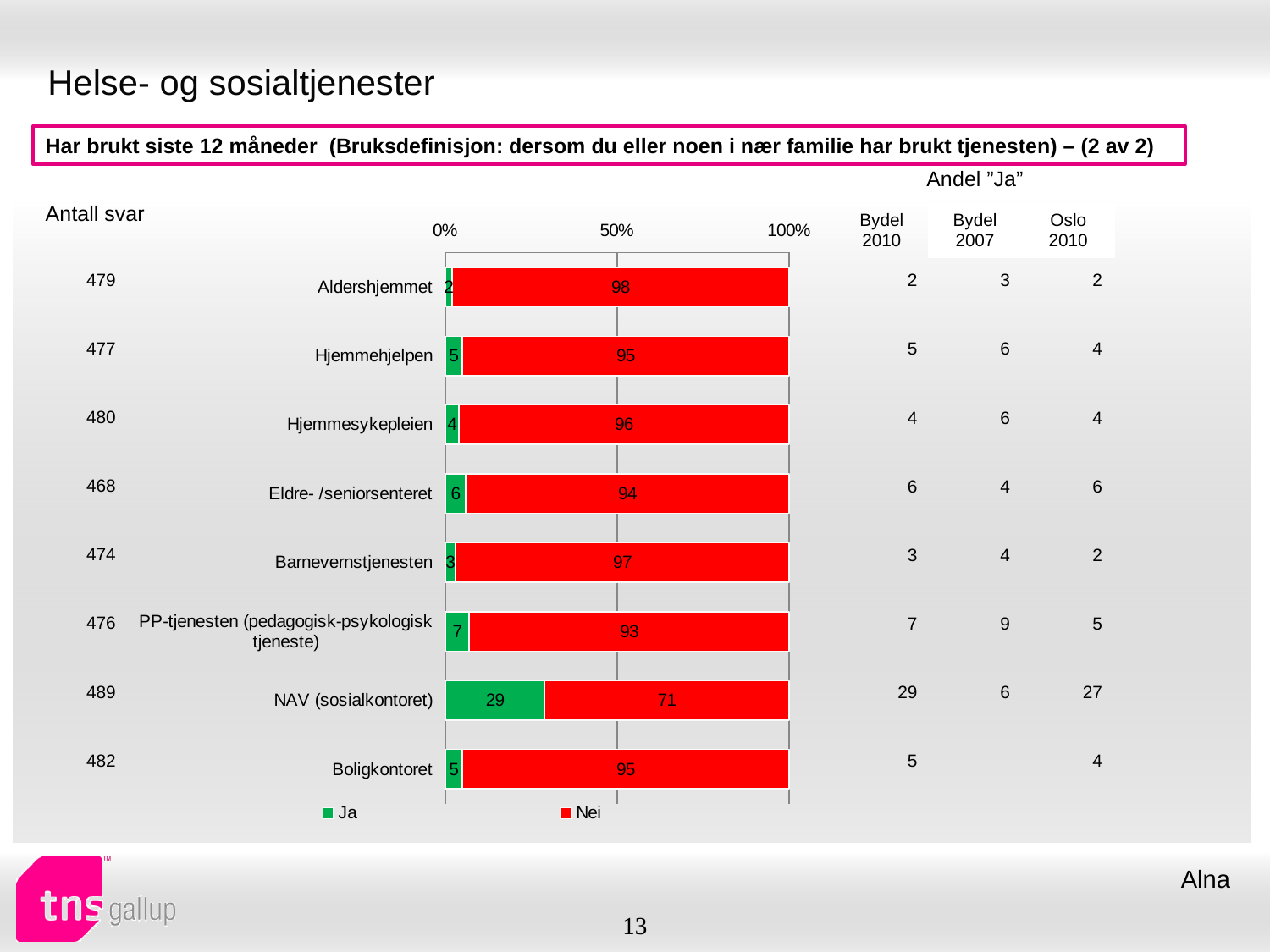
Which category has the lowest "Ja" value? Aldershjemmet What is the "Ja" value for PP-tjenesten (pedagogisk-psykologisk tjeneste)? 7 What is the difference between the "Nei" values for Aldershjemmet and NAV (sosialkontoret)? 27 How many categories are shown in the chart? 8 Which category has the highest "Ja" value? NAV (sosialkontoret) What is the "Nei" value for NAV (sosialkontoret)? 71 What kind of chart is shown on the slide? Stacked bar chart What is the "Nei" value for Aldershjemmet? 98 Is the "Nei" value for NAV (sosialkontoret) greater or less than 50%? greater What is the total of the stacked bar for Hjemmesykepleien? 100 How many series does the legend list? 2 Which is larger, the "Ja" value for Eldre- /seniorsenteret or for Barnevernstjenesten? Eldre- /seniorsenteret